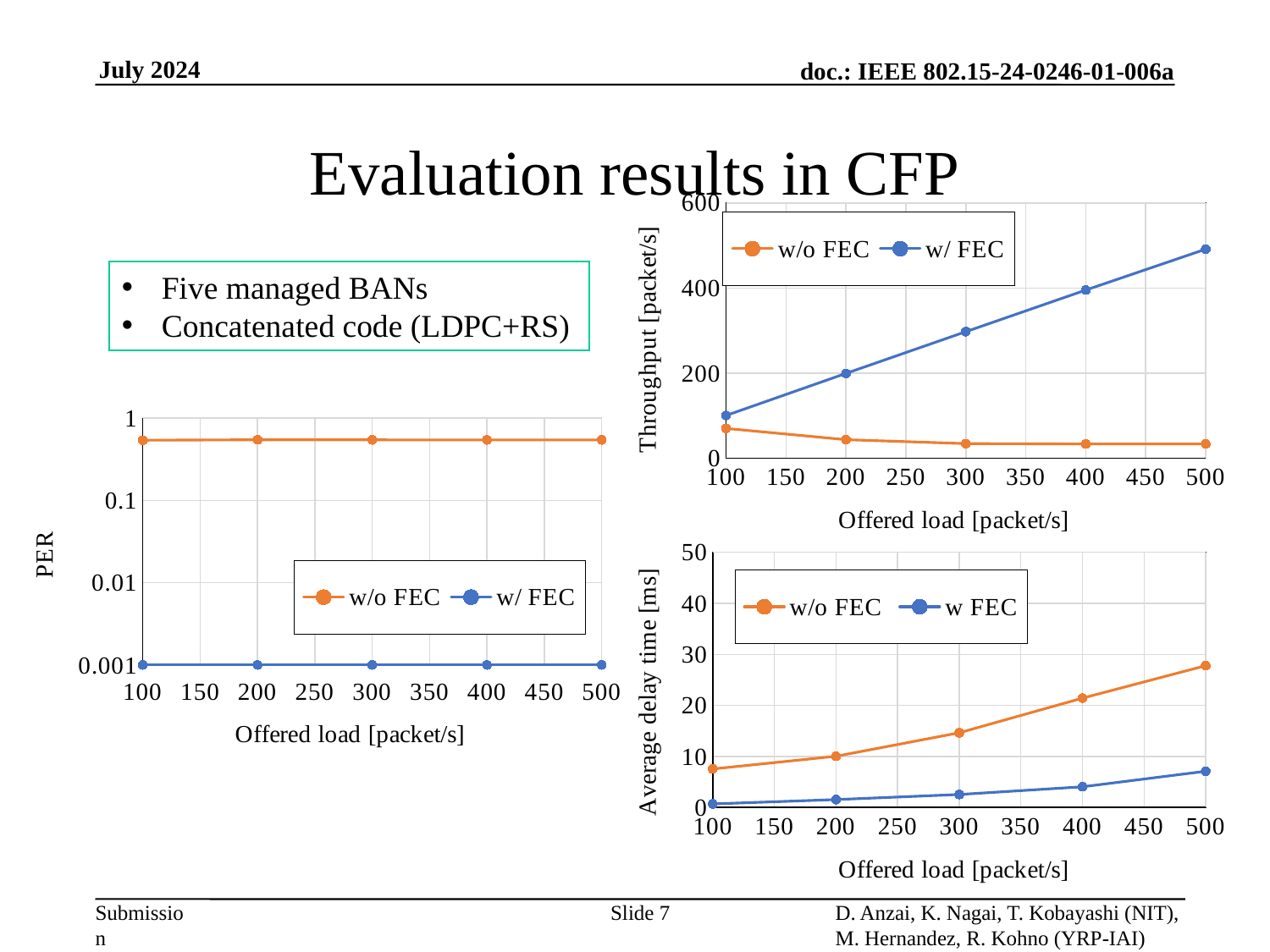
In the Throughput chart, does the w/o FEC series rise or fall as offered load increases? fall How many data points does the w/ FEC series have in the Average delay time chart? 5 In the Average delay time chart, is the w/o FEC delay at an offered load of 500 packet/s greater or less than 20 ms? greater In the PER chart, which series has the lower PER, w/o FEC or w/ FEC? w/ FEC In the Throughput chart, does the w/ FEC series rise or fall as offered load increases? rise In the Average delay time chart, which series has the higher delay at an offered load of 500 packet/s, w/o FEC or w FEC? w/o FEC In the PER chart, is the PER for w/o FEC at an offered load of 300 packet/s greater or less than 0.1? greater In the Throughput chart, is the w/ FEC throughput at an offered load of 500 packet/s greater or less than 400? greater What kind of chart is the Throughput chart on the top right of the slide? line chart How many series does the legend of the PER chart list? 2